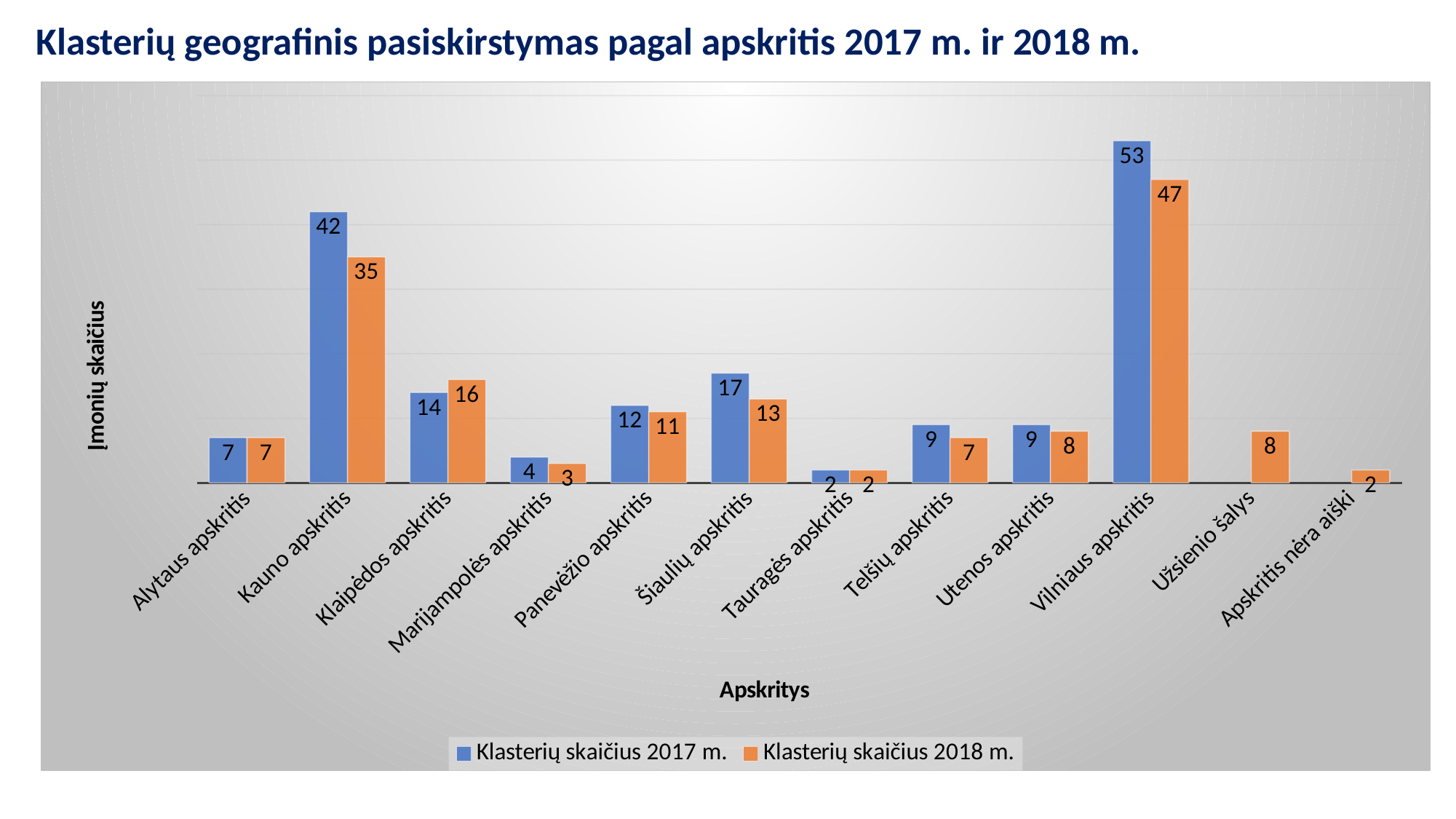
What is the label of the y axis? Įmonių skaičius What is the title of the chart? Klasterių geografinis pasiskirstymas pagal apskritis 2017 m. ir 2018 m. What is the value for Vilniaus apskritis in the Klasterių skaičius 2018 m. series? 47 What is the value for Kauno apskritis in the Klasterių skaičius 2017 m. series? 42 Which category has the highest value in the Klasterių skaičius 2017 m. series? Vilniaus apskritis What kind of chart is shown on the slide? Bar chart Which category has the lowest value in the Klasterių skaičius 2017 m. series among those with a 2017 bar? Tauragės apskritis How many series does the legend list? 2 Which is larger for Klaipėdos apskritis: the 2017 value or the 2018 value? 2018 value How many categories are shown on the x axis? 12 What is the difference between the 2017 and 2018 values for Kauno apskritis? 7 What is the value for Užsienio šalys in the Klasterių skaičius 2018 m. series? 8